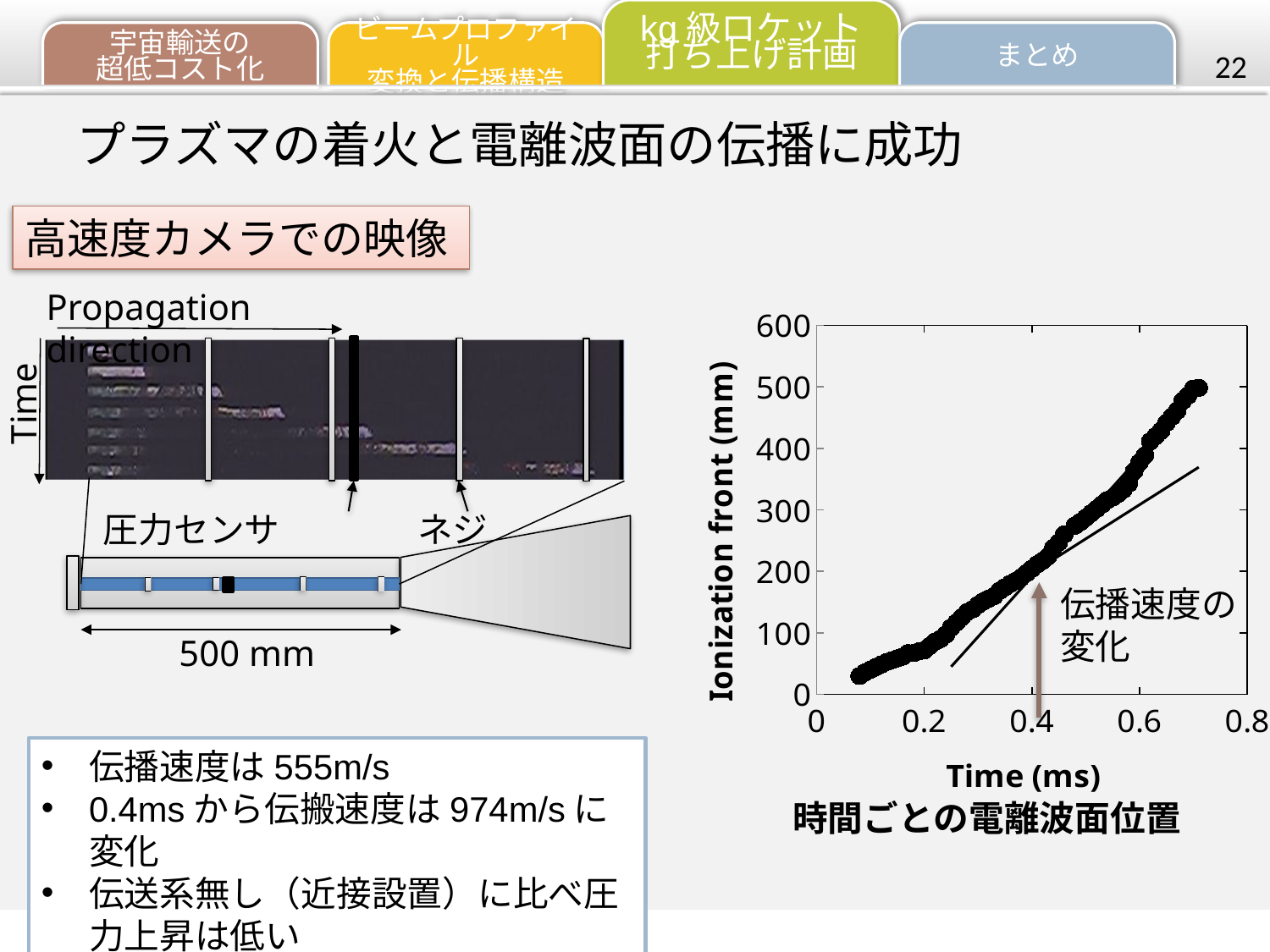
Is the ionization front value at 0.1 ms greater or less than 100? less What kind of chart is shown on the right side of the slide? scatter chart Do the plotted values of ionization front rise or fall as time increases along the x axis? rise What is the label of the vertical axis of the chart? Ionization front (mm) Which is larger, the ionization front value at 0.6 ms or at 0.3 ms? 0.6 ms Is the ionization front value at 0.6 ms greater or less than 300? greater What is the highest tick value shown on the vertical axis of the chart? 600 Is the ionization front value at 0.3 ms greater or less than 200? less What is the label of the horizontal axis of the chart? Time (ms)